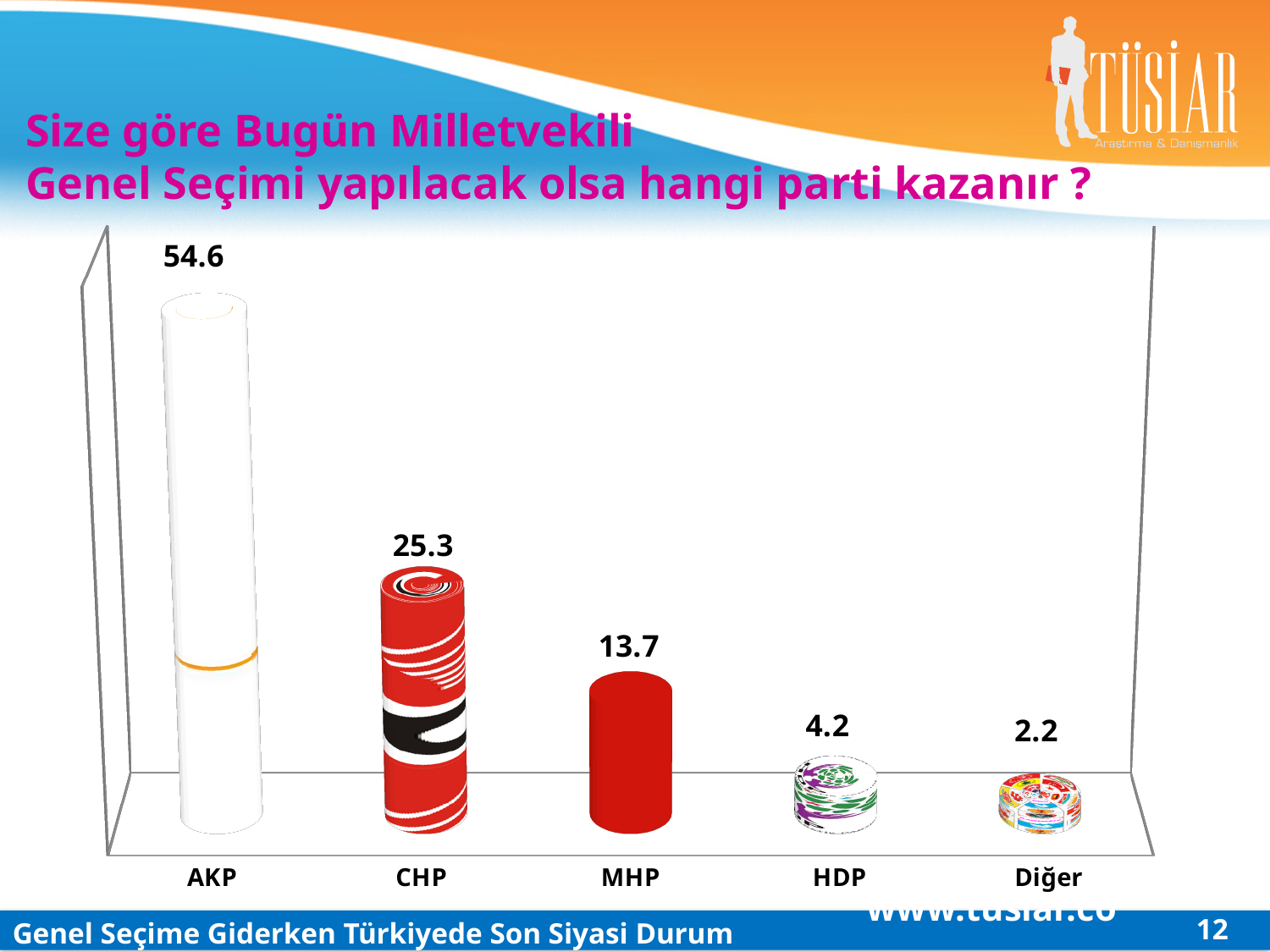
Which category has the highest value? AKP Which category has the lowest value? Diğer What is the value for AKP? 54.6 What is the value for Diğer? 2.2 What is the value for MHP? 13.7 What is the value for HDP? 4.2 What is the difference between the values for MHP and HDP? 9.5 What is the difference between the values for AKP and CHP? 29.3 What is the value for CHP? 25.3 How many categories are shown on the x axis? 5 What kind of chart is shown on the slide? Bar chart Which is larger, the value for CHP or the value for MHP? CHP